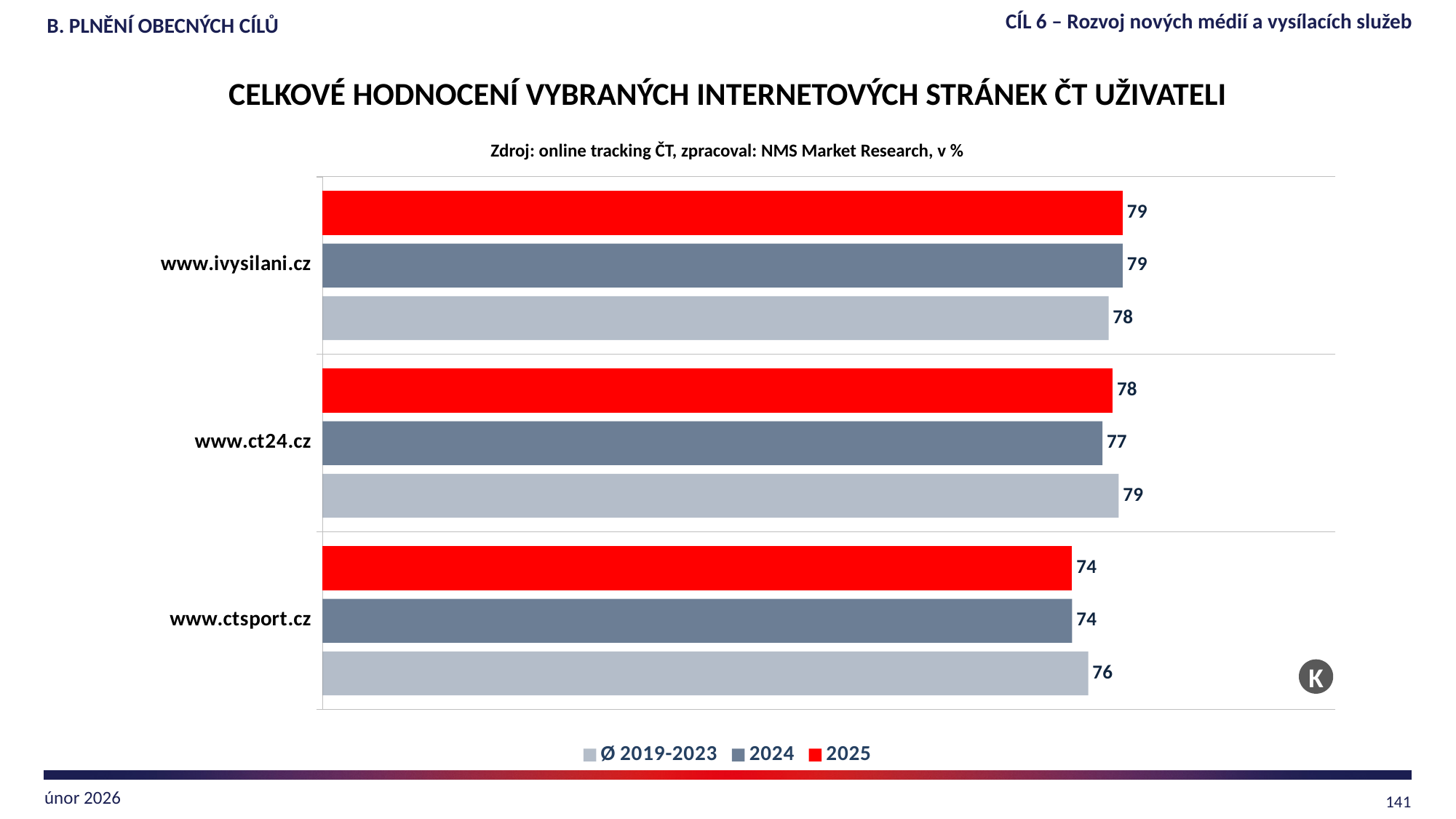
What is the 2025 value for www.ctsport.cz? 74 How many websites are shown in the chart? 3 Which website has the highest 2024 value? www.ivysilani.cz What is the Ø 2019-2023 value for www.ctsport.cz? 76 How many series does the legend list? 3 What is the 2024 value for www.ct24.cz? 77 What kind of chart is shown on the slide? Bar chart Which website has the lowest 2025 value? www.ctsport.cz What is the 2025 value for www.ivysilani.cz? 79 For www.ctsport.cz, which is larger: the Ø 2019-2023 value or the 2025 value? Ø 2019-2023 What is the difference between the Ø 2019-2023 value and the 2025 value for www.ct24.cz? 1 What is the difference between the 2025 values for www.ivysilani.cz and www.ctsport.cz? 5